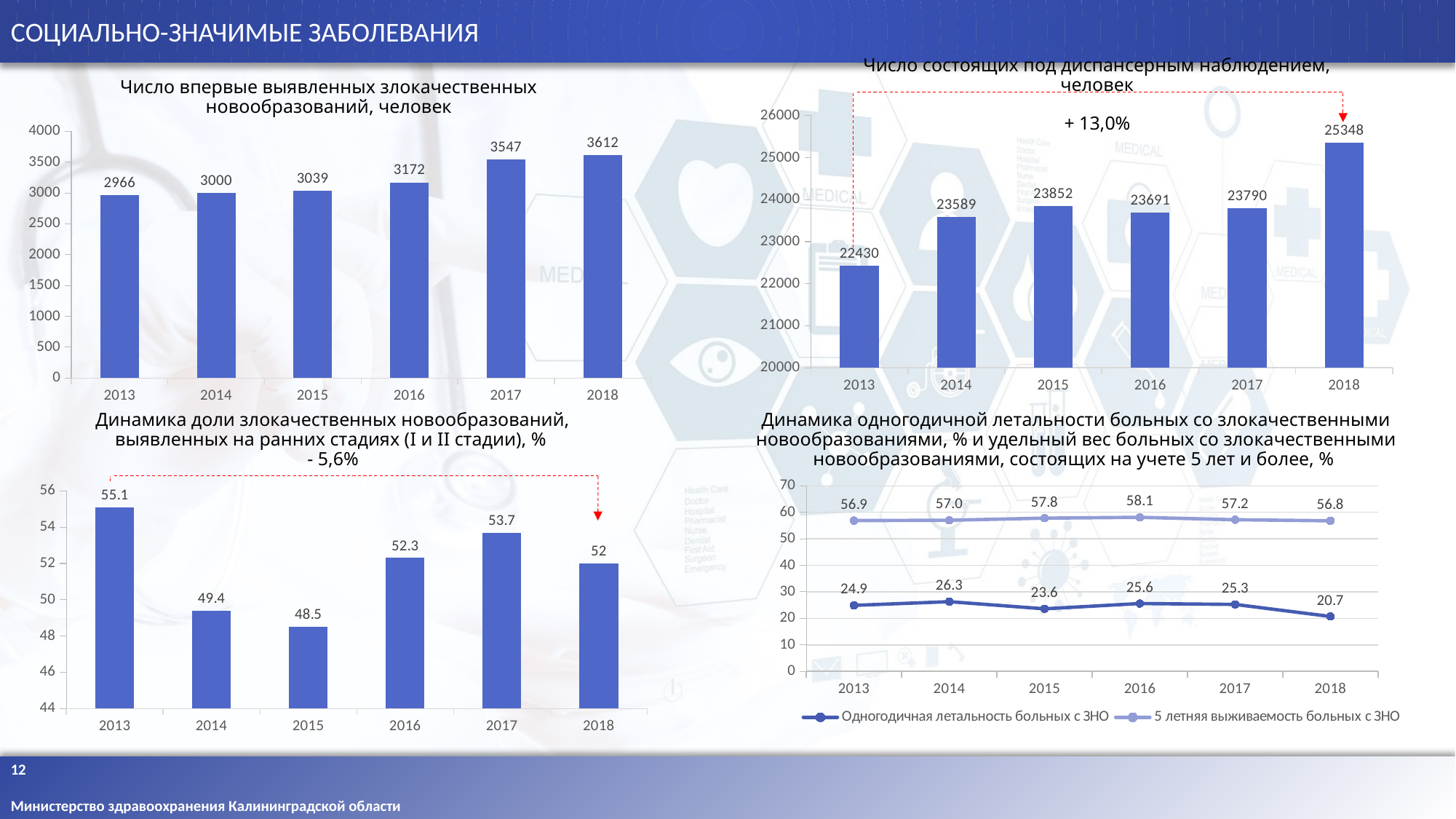
In the top-left chart (Число впервые выявленных злокачественных новообразований), which year has the highest value? 2018 In the top-right chart (Число состоящих под диспансерным наблюдением), what is the value for 2015? 23852 In the top-left chart (Число впервые выявленных злокачественных новообразований), what is the difference between the 2018 and 2013 values? 646 In the top-right chart (Число состоящих под диспансерным наблюдением), which year has the lowest value? 2013 In the top-left chart (Число впервые выявленных злокачественных новообразований), what is the value for 2016? 3172 In the bottom-right chart (Динамика одногодичной летальности), what is the value of Одногодичная летальность больных с ЗНО for 2018? 20.7 What kind of chart is the bottom-right chart (Динамика одногодичной летальности)? line chart In the bottom-left chart (Динамика доли злокачественных новообразований, выявленных на ранних стадиях), how many years are shown on the x axis? 6 In the bottom-left chart (Динамика доли злокачественных новообразований, выявленных на ранних стадиях), which is larger, the value for 2017 or the value for 2018? 2017 In the bottom-left chart (Динамика доли злокачественных новообразований, выявленных на ранних стадиях), what is the value for 2015? 48.5 In the top-right chart (Число состоящих под диспансерным наблюдением), what percentage change is annotated between 2013 and 2018? + 13,0% In the bottom-right chart (Динамика одногодичной летальности), how many series does the legend list? 2